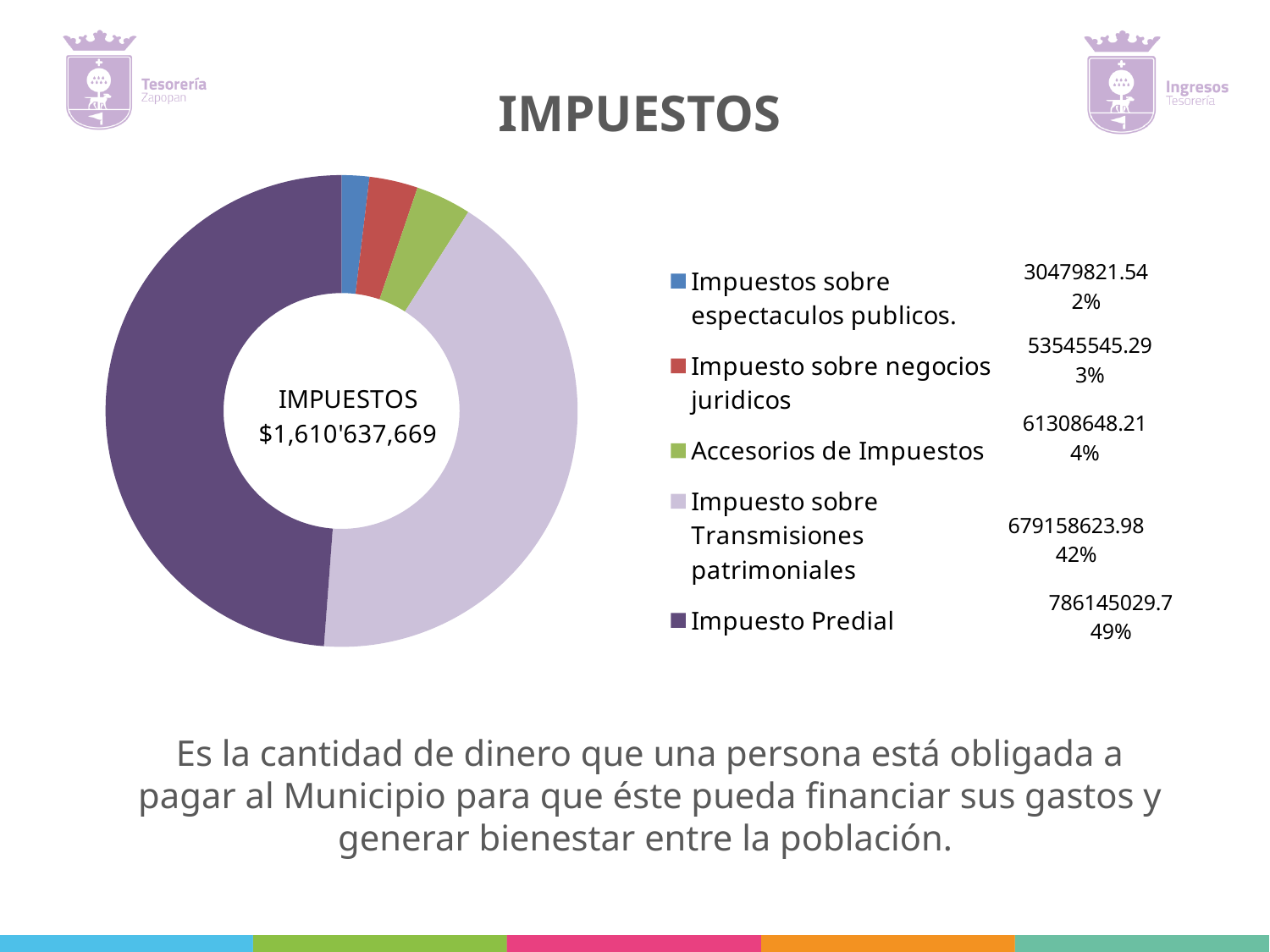
What is the difference between the values for Impuesto Predial and Impuesto sobre Transmisiones patrimoniales? 106986405.72 What value is shown for Impuesto Predial? 786145029.7 What percentage share does Impuesto sobre negocios juridicos have? 3% Which category has the largest value? Impuesto Predial What value is shown for Accesorios de Impuestos? 61308648.21 Which category has the smallest value? Impuestos sobre espectaculos publicos. What value is shown for Impuesto sobre Transmisiones patrimoniales? 679158623.98 Which is larger, Accesorios de Impuestos or Impuesto sobre negocios juridicos? Accesorios de Impuestos What kind of chart is shown on the slide? doughnut chart What percentage share does Impuesto Predial have? 49% What value is shown for Impuestos sobre espectaculos publicos? 30479821.54 How many categories does the chart show? 5